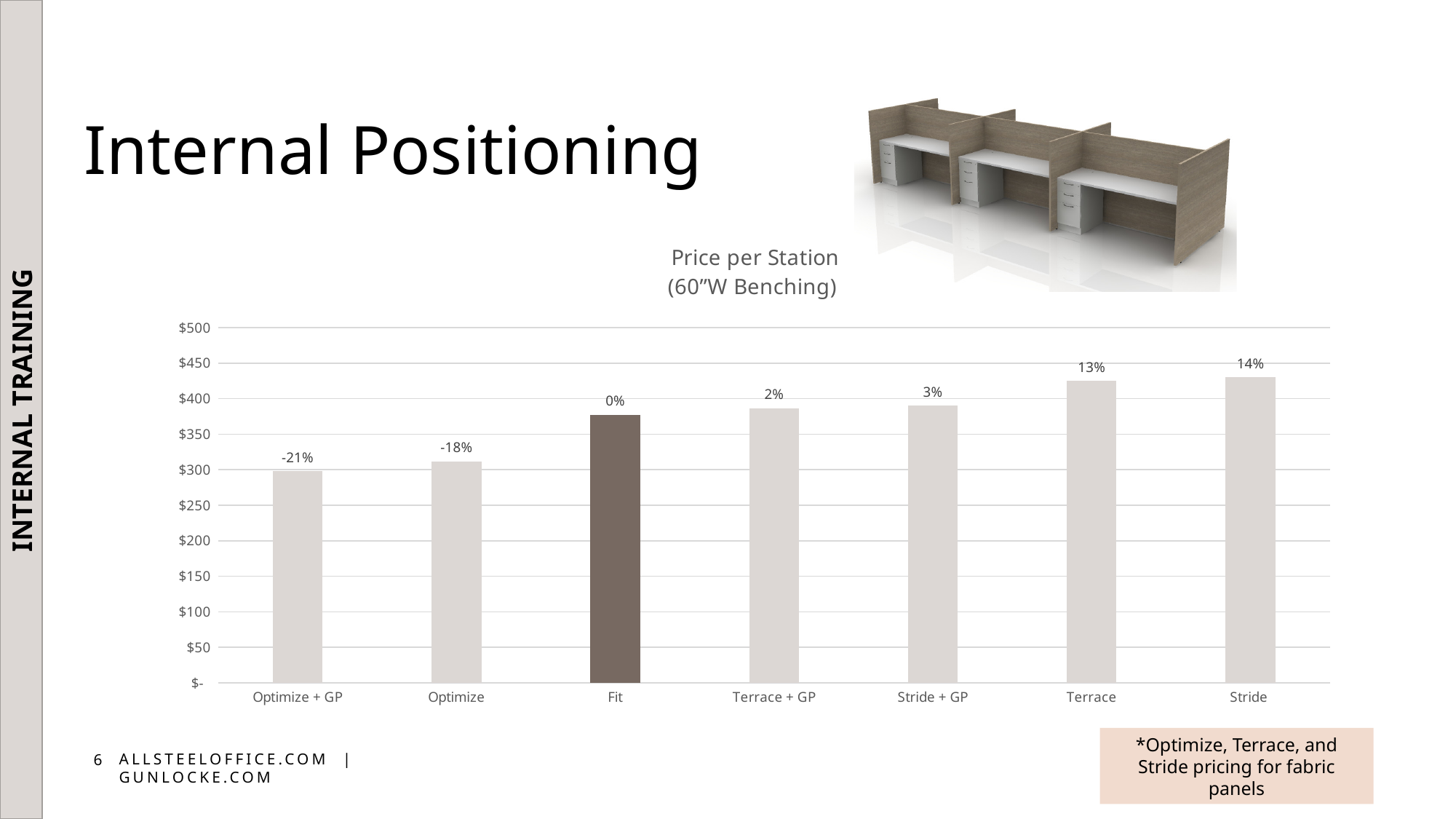
Is the price per station for Terrace greater or less than $400? greater Which category has the lowest price per station? Optimize + GP Is the price per station for Fit greater or less than $350? greater Which category has the highest price per station? Stride What percentage label is shown above the Fit bar? 0% Which has a higher price per station, Terrace + GP or Optimize? Terrace + GP Is the price per station for Optimize + GP greater or less than $350? less What percentage label is shown above the Terrace bar? 13% What percentage label is shown above the Optimize bar? -18% How many product categories are shown on the x axis of the Price per Station chart? 7 Do the bar values rise or fall moving from left to right along the x axis? rise What kind of chart is shown on the slide? bar chart